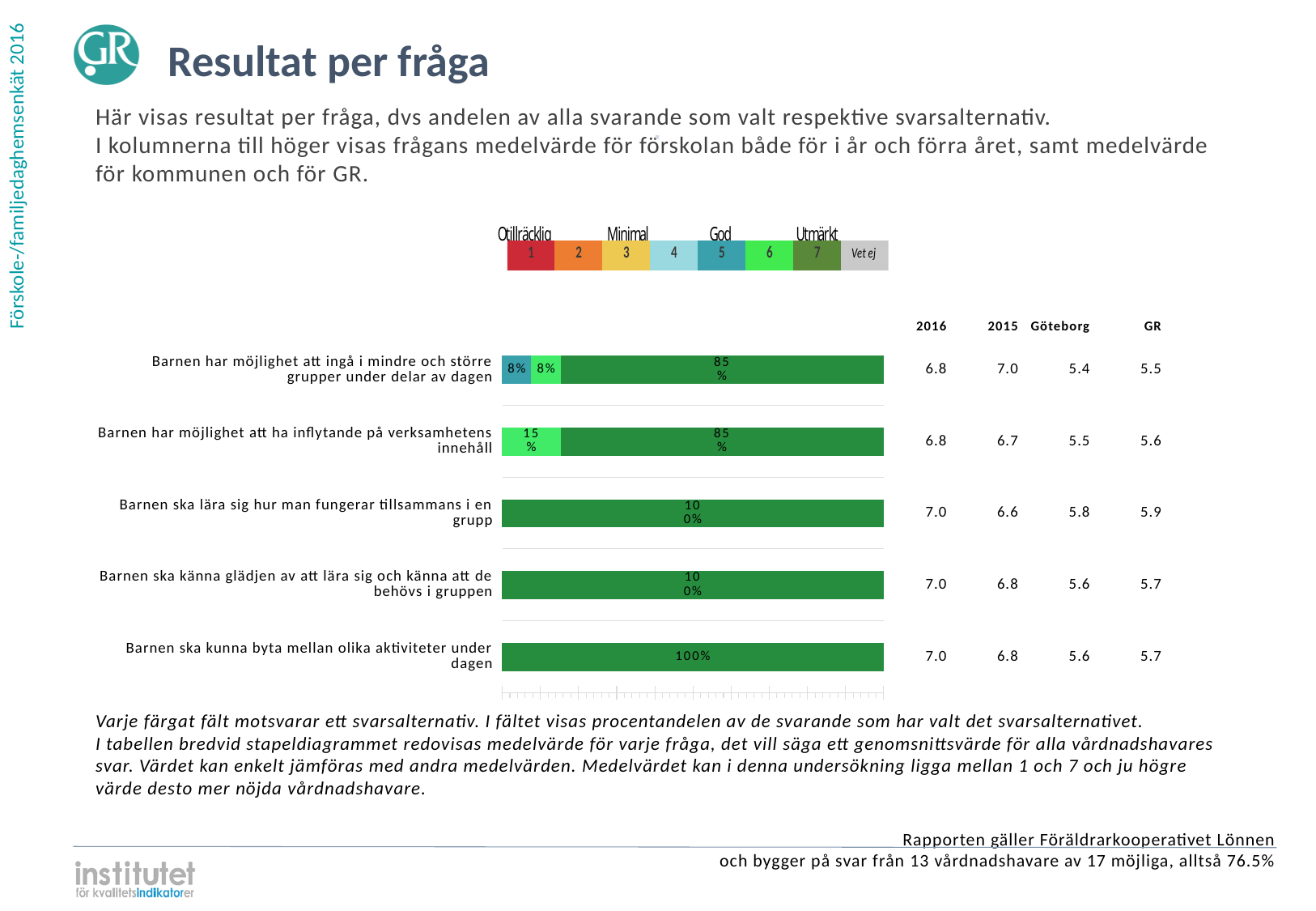
What percentage is shown for 'Barnen ska kunna byta mellan olika aktiviteter under dagen'? 100% What is the 2016 mean value for 'Barnen ska lära sig hur man fungerar tillsammans i en grupp'? 7.0 How many answer alternatives does the legend above the chart list, including 'Vet ej'? 8 Which question has the lowest 2015 mean value? Barnen ska lära sig hur man fungerar tillsammans i en grupp What is the difference between the 2016 and 2015 mean values for 'Barnen ska lära sig hur man fungerar tillsammans i en grupp'? 0.4 What percentage of respondents chose answer 6 for 'Barnen har möjlighet att ha inflytande på verksamhetens innehåll'? 15% What percentage of respondents chose answer 7 (Utmärkt) for 'Barnen har möjlighet att ingå i mindre och större grupper under delar av dagen'? 85% What kind of chart is used to show the results per question? bar chart What is the Göteborg mean value for 'Barnen har möjlighet att ingå i mindre och större grupper under delar av dagen'? 5.4 What is the total of the percentages shown in the bar for 'Barnen har möjlighet att ingå i mindre och större grupper under delar av dagen'? 101% How many questions (categories) are shown in the bar chart? 5 Which is larger for 'Barnen har möjlighet att ingå i mindre och större grupper under delar av dagen': the 2016 mean or the 2015 mean? 2015